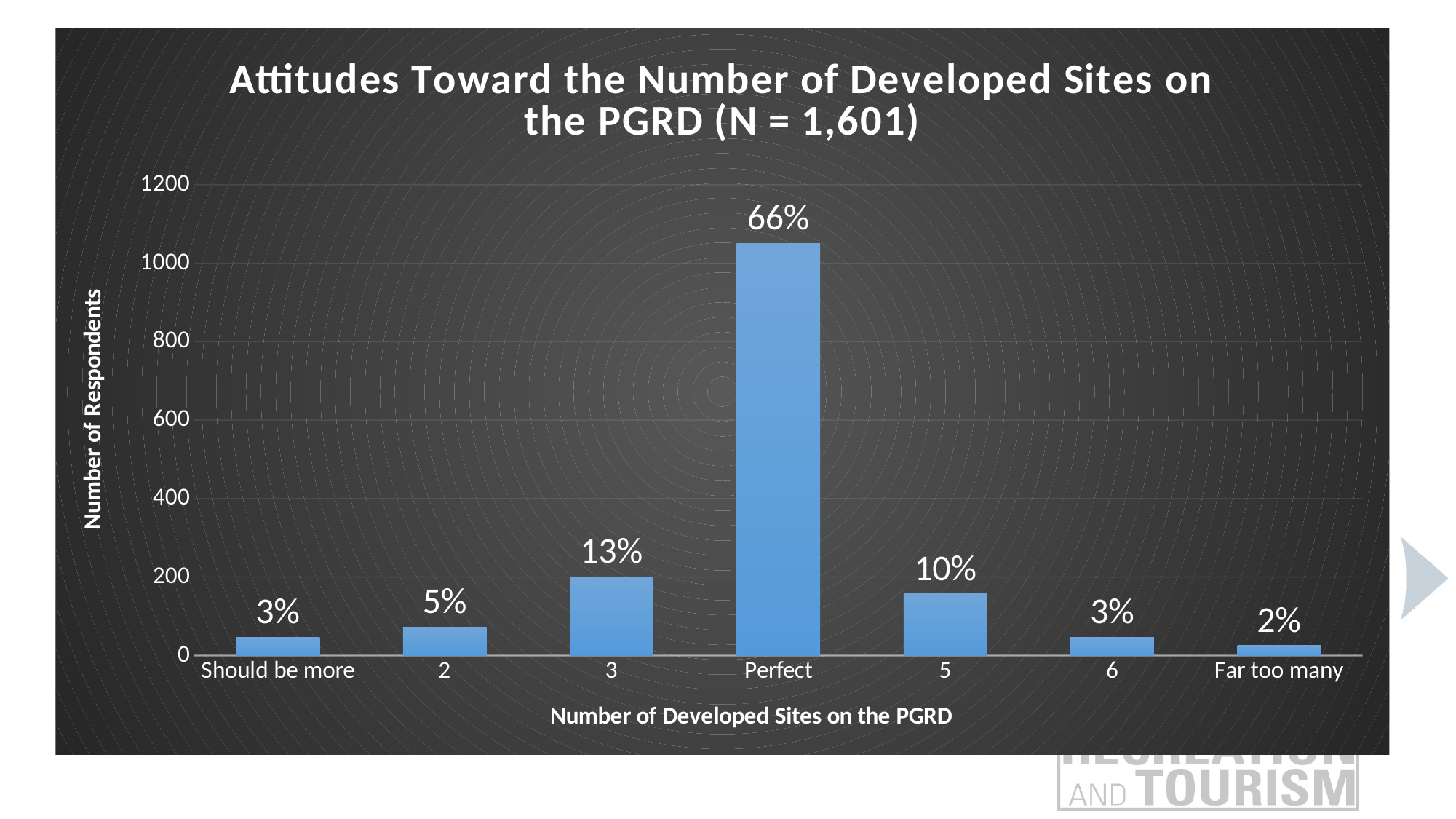
Which category has the highest number of respondents? Perfect Is the number of respondents for "Perfect" greater or less than 1000? greater By how many percentage points does the "Perfect" label exceed the "3" label? 53 percentage points What percentage label is shown on the bar for "3" developed sites? 13% What percentage label is shown on the bar for "Far too many"? 2% Which has more respondents: "3" or "5" developed sites? 3 Which category has the lowest number of respondents? Far too many What percentage label is shown on the bar for "Perfect"? 66% What percentage label is shown on the bar for "5" developed sites? 10% Is the number of respondents for "5" developed sites greater or less than 200? less What kind of chart is shown on the slide? Bar chart How many categories are shown on the x axis? 7